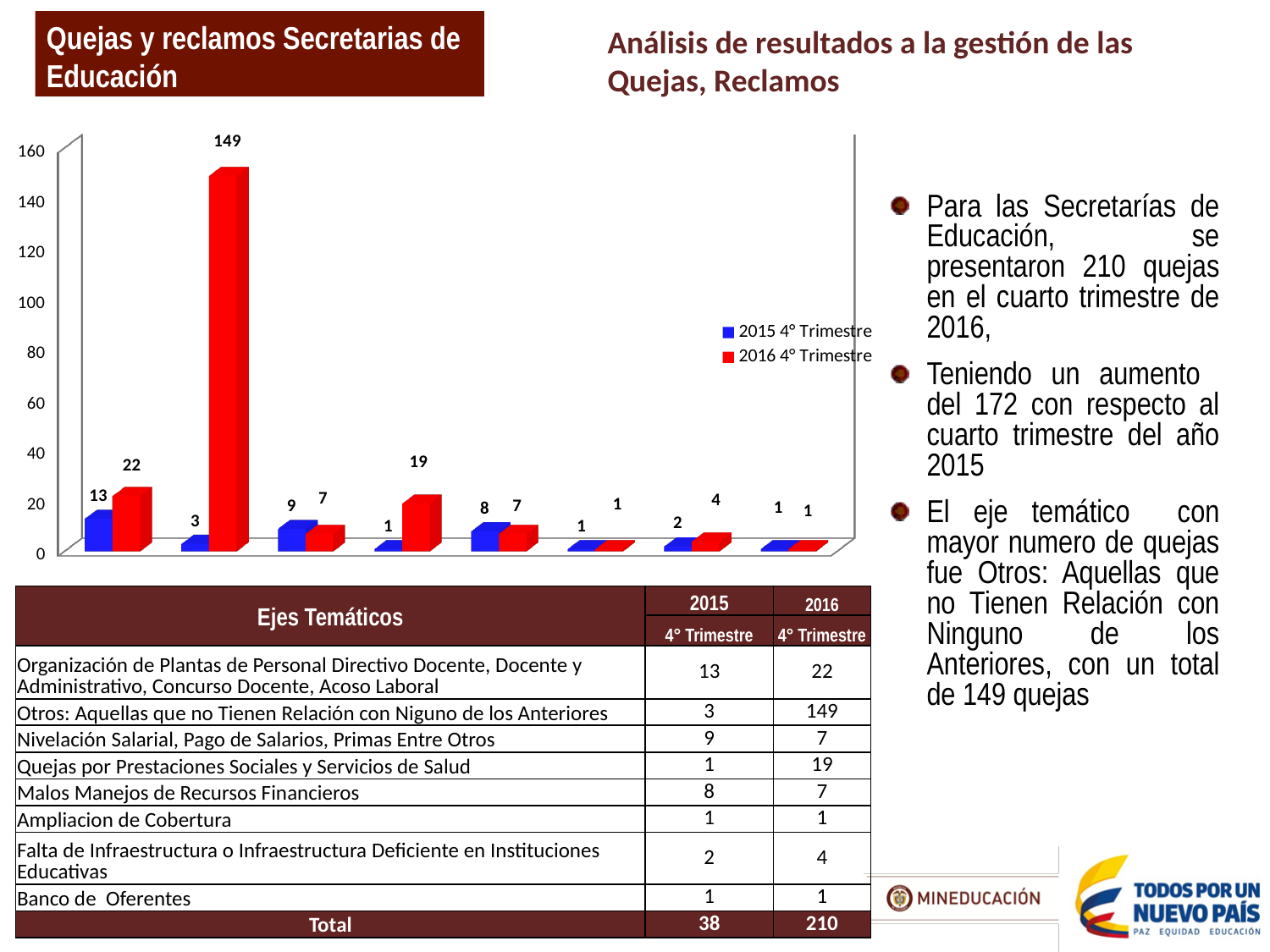
Which colour represents the 2016 4° Trimestre series in the chart? red What is the highest value shown in the chart for the 2016 4° Trimestre series? 149 How many series does the chart legend list? 2 What kind of chart is shown on the slide? bar chart In the chart, what is the 2015 4° Trimestre value for the first category (Organización de Plantas de Personal Directivo Docente...)? 13 Is the tallest bar in the chart greater or less than 140? greater What is the difference between the 2016 and 2015 4° Trimestre values for the first category in the chart? 9 In the chart, what is the 2016 4° Trimestre value for the fourth category (Quejas por Prestaciones Sociales y Servicios de Salud)? 19 How many categories (pairs of bars) are plotted in the chart? 8 What is the value of the tallest bar in the chart? 149 For the first category in the chart, which series has the larger value, 2015 4° Trimestre or 2016 4° Trimestre? 2016 4° Trimestre What is the difference between the 2016 and 2015 4° Trimestre values for the category Otros: Aquellas que no Tienen Relación con Ninguno de los Anteriores? 146